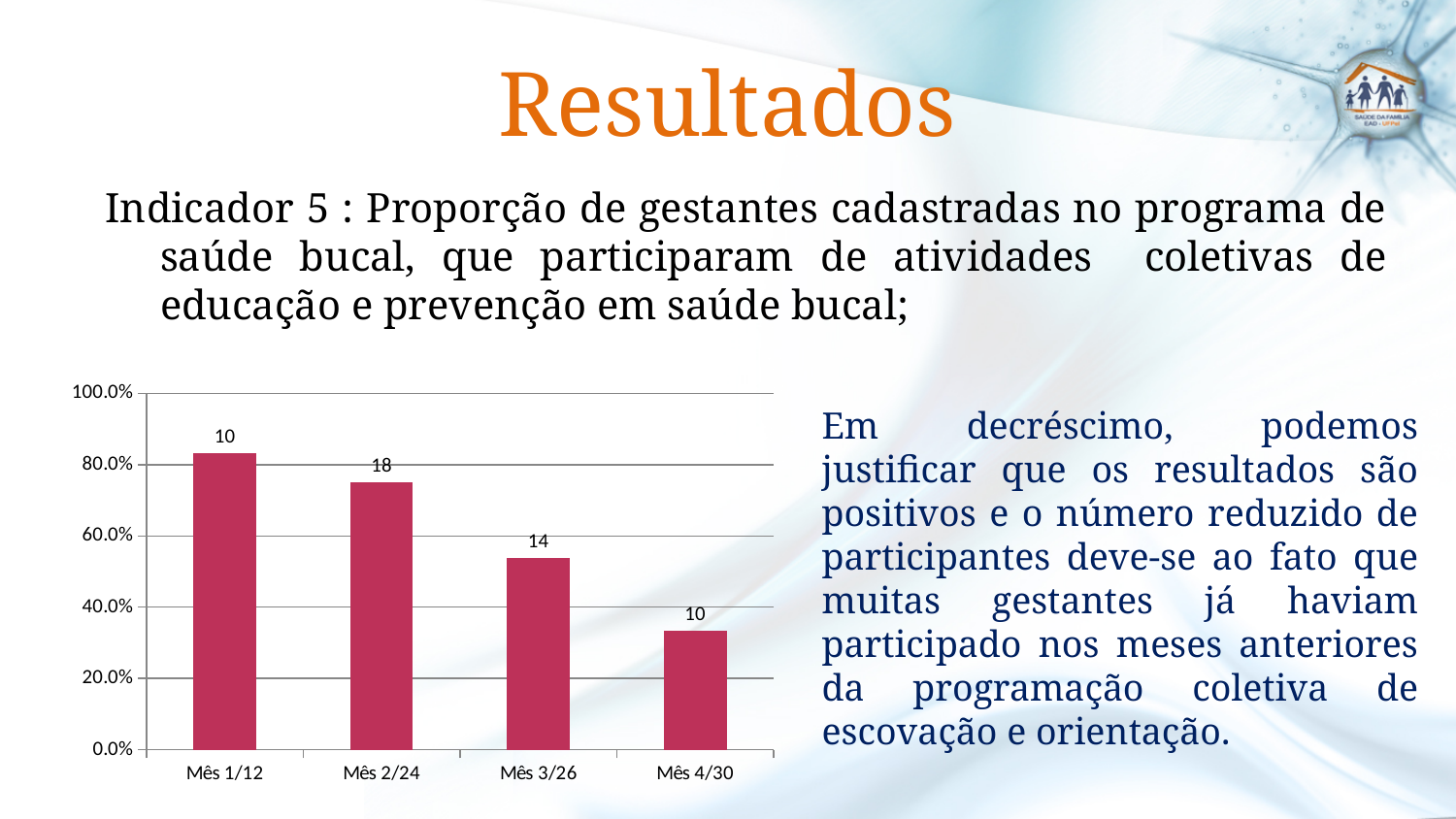
Which bar is taller, Mês 2/24 or Mês 3/26? Mês 2/24 Which category has the shortest bar? Mês 4/30 Is the bar for Mês 2/24 greater or less than 60.0%? greater What data label is printed above the bar for Mês 2/24? 18 What data label is printed above the bar for Mês 3/26? 14 How many categories (bars) does the chart show? 4 What kind of chart is shown on the slide? bar chart What data label is printed above the bar for Mês 4/30? 10 Do the bar heights rise or fall from Mês 1/12 to Mês 4/30? fall What is the difference between the data labels for Mês 2/24 and Mês 4/30? 8 Is the bar for Mês 4/30 greater or less than 40.0%? less Which category has the tallest bar? Mês 1/12